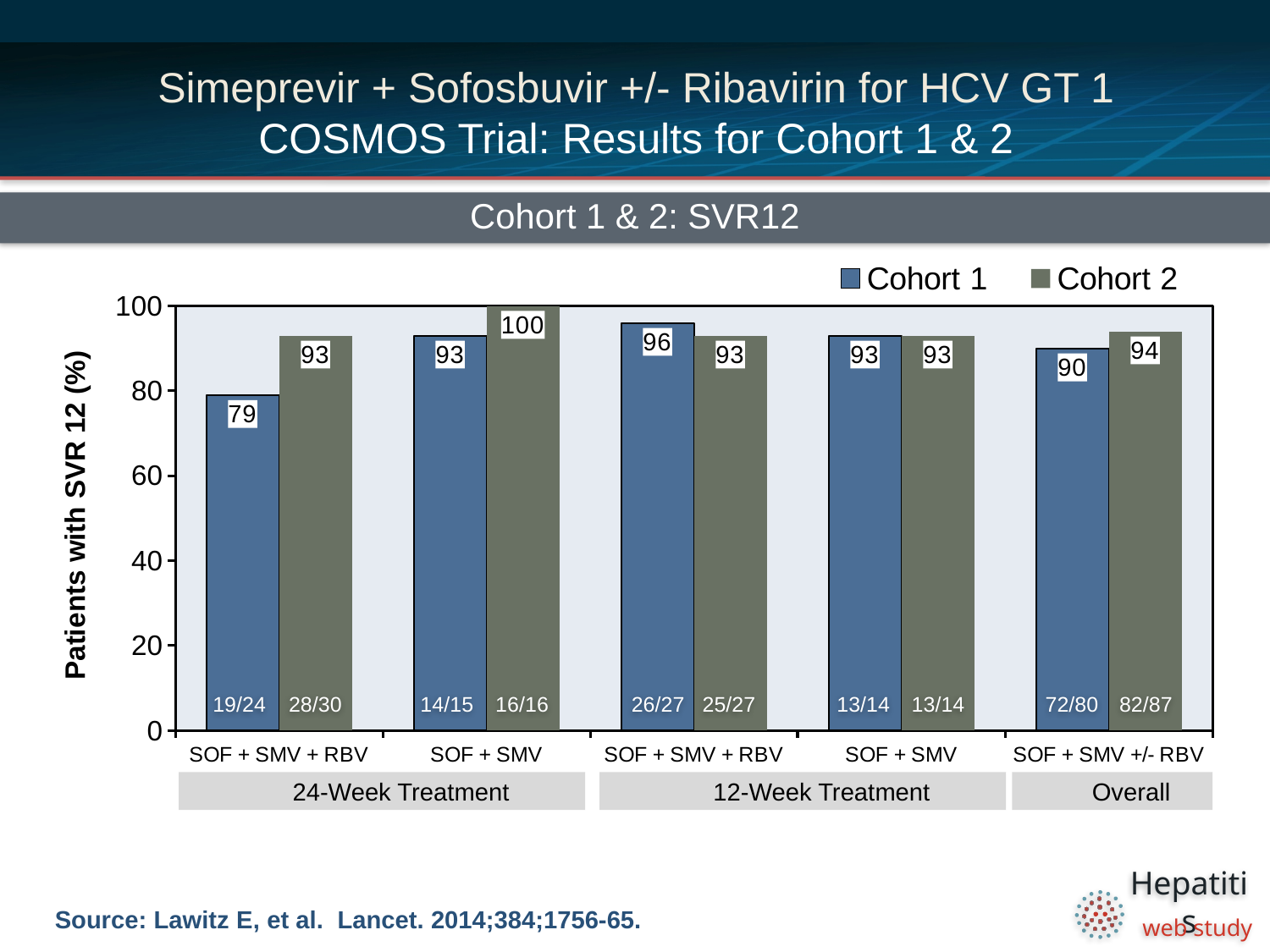
What is the Overall SVR12 rate for Cohort 2 (SOF + SMV +/- RBV)? 94 Which bar has the highest SVR12 rate on the chart? Cohort 2, 24-Week Treatment SOF + SMV What fraction of patients is shown for Cohort 1 in the Overall group? 72/80 What kind of chart is shown on the slide? Bar chart What is the SVR12 rate for Cohort 2 in the 24-Week Treatment SOF + SMV group? 100 In the 12-Week Treatment SOF + SMV + RBV group, which cohort has the higher SVR12 rate? Cohort 1 What is the difference between the Cohort 2 and Cohort 1 SVR12 rates in the 24-Week Treatment SOF + SMV + RBV group? 14 How many treatment groups are shown along the x axis? 5 Which bar has the lowest SVR12 rate on the chart? Cohort 1, 24-Week Treatment SOF + SMV + RBV How many series does the legend list? 2 What is the SVR12 rate for Cohort 1 in the 24-Week Treatment SOF + SMV + RBV group? 79 What is the SVR12 rate for Cohort 1 in the 12-Week Treatment SOF + SMV + RBV group? 96